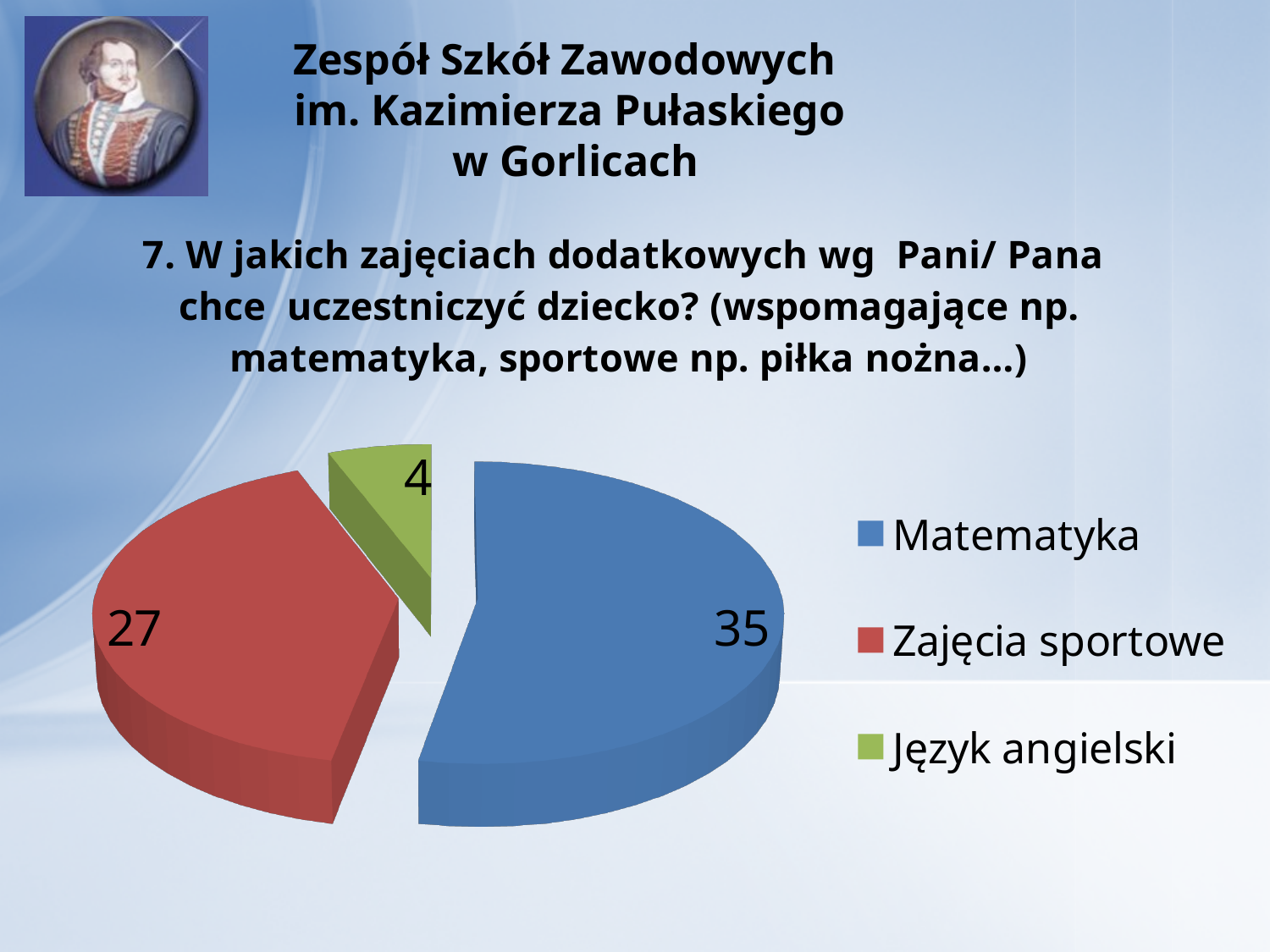
What is the total of all the slices in the pie chart? 66 What is the difference between the values for Matematyka and Zajęcia sportowe? 8 What colour is the slice for Zajęcia sportowe? red Which is larger, the value for Zajęcia sportowe or the value for Język angielski? Zajęcia sportowe What is the value for Język angielski? 4 Which category has the largest slice of the pie? Matematyka Which category has the smallest slice of the pie? Język angielski How many categories does the pie chart show? 3 What is the difference between the values for Zajęcia sportowe and Język angielski? 23 What type of chart is shown on the slide? pie chart What is the value for Zajęcia sportowe? 27 What is the value for Matematyka? 35